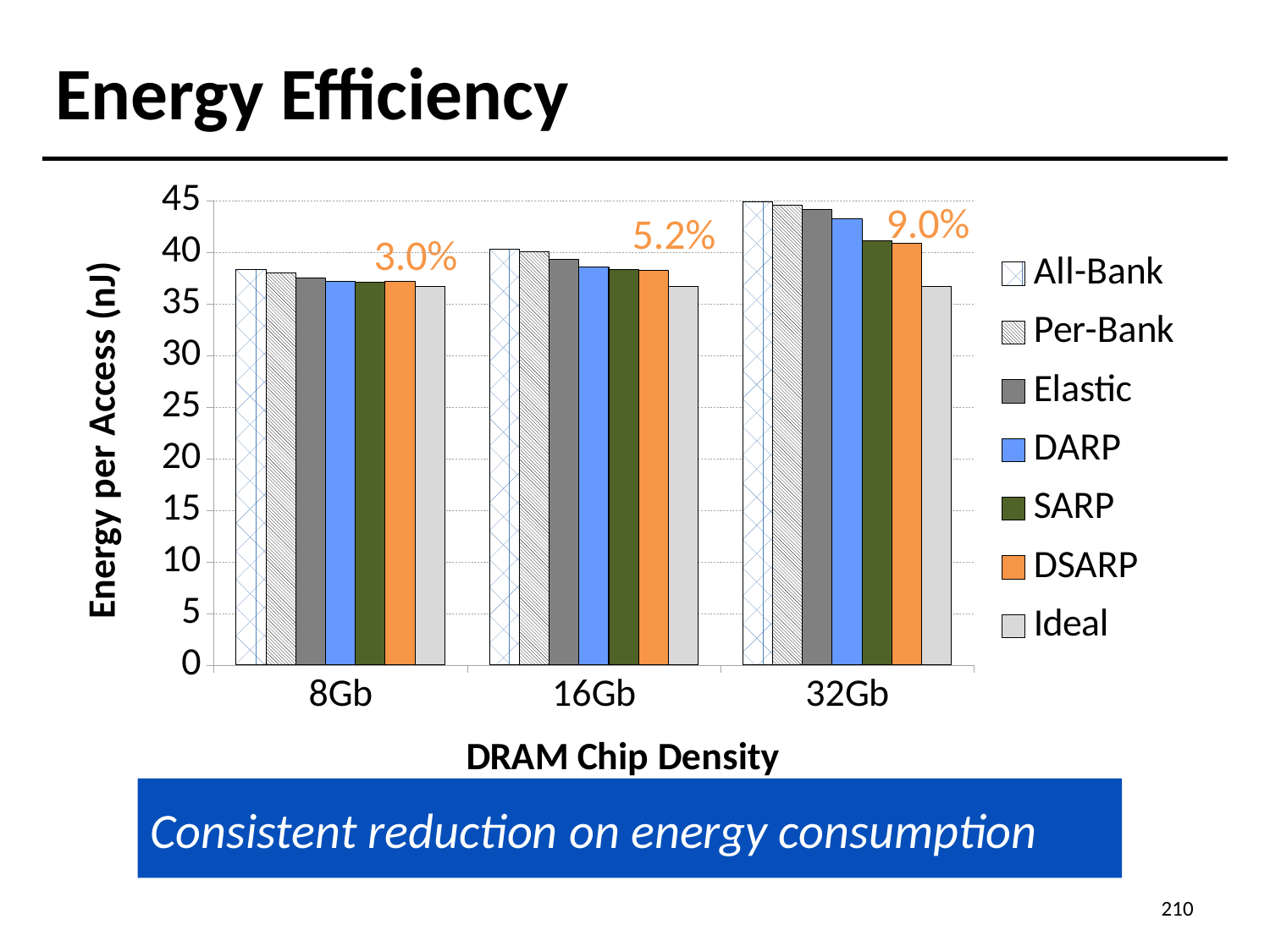
Is the DSARP value at 16Gb greater or less than 35? greater How many DRAM chip density categories are shown on the x axis? 3 What percentage is annotated above the 32Gb group of bars? 9.0% Which series has the lowest energy per access at 32Gb? Ideal Is the Ideal value at 8Gb greater or less than 40? less How many series does the legend list? 7 Is the All-Bank value at 8Gb greater or less than 35? greater What kind of chart is shown on the slide? bar chart At which DRAM chip density is the All-Bank energy per access highest? 32Gb Does the All-Bank energy per access rise or fall as DRAM chip density increases from 8Gb to 32Gb? rise At 32Gb, which is larger: the All-Bank value or the Ideal value? All-Bank